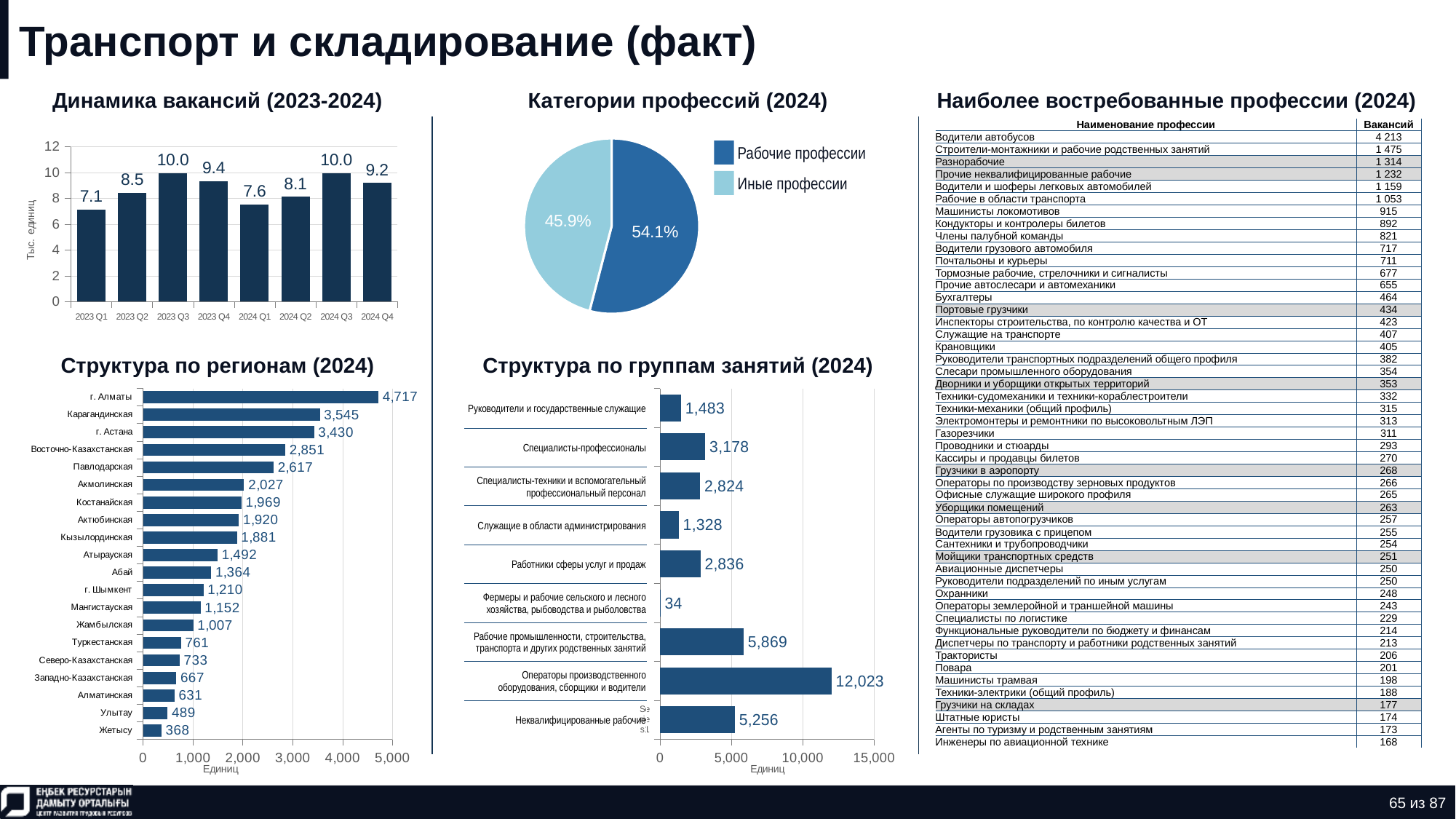
In the 'Структура по группам занятий (2024)' chart, which group has the lowest value? Фермеры и рабочие сельского и лесного хозяйства, рыбоводства и рыболовства What kind of chart is 'Структура по группам занятий (2024)'? Bar chart In the 'Структура по регионам (2024)' chart, what is the value for Карагандинская? 3,545 In the 'Структура по регионам (2024)' chart, which region has the highest value? г. Алматы In the 'Структура по группам занятий (2024)' chart, what is the value for 'Неквалифицированные рабочие'? 5,256 In the 'Динамика вакансий (2023-2024)' chart, what is the value for 2023 Q1? 7.1 In the 'Категории профессий (2024)' pie chart, what share do 'Рабочие профессии' have? 54.1% In the 'Категории профессий (2024)' pie chart, how many categories does the legend list? 2 In the 'Структура по регионам (2024)' chart, which is larger: г. Астана or Павлодарская? г. Астана In the 'Динамика вакансий (2023-2024)' chart, what is the difference between 2024 Q3 and 2024 Q1? 2.4 In the 'Динамика вакансий (2023-2024)' chart, how many quarters are plotted? 8 In the 'Динамика вакансий (2023-2024)' chart, which quarter has the lowest value? 2023 Q1